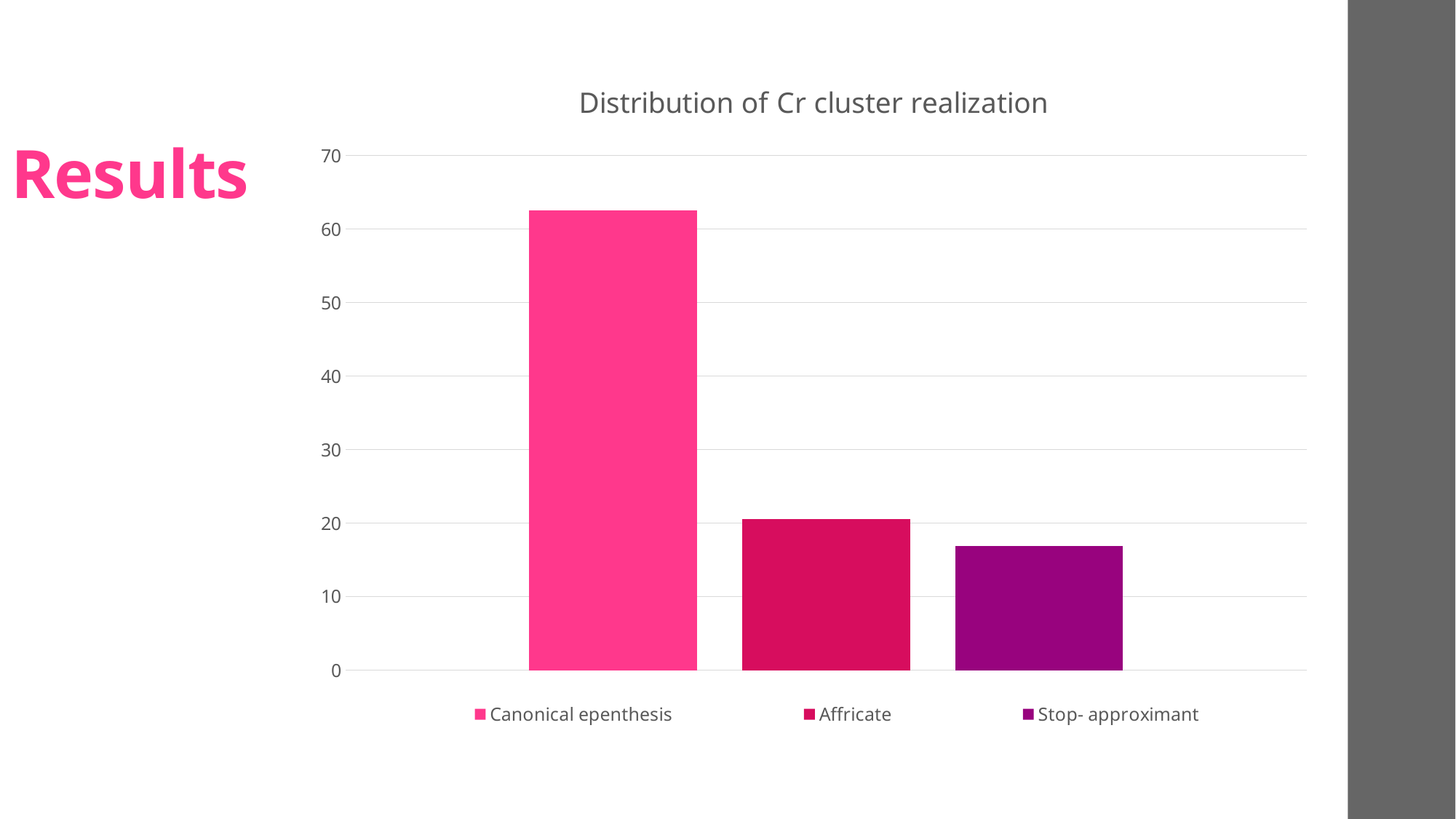
What is the title of the chart? Distribution of Cr cluster realization Is the value for Canonical epenthesis greater or less than 60? greater Which category has the highest value? Canonical epenthesis Which category has the lowest value? Stop- approximant Is the value for Stop- approximant greater or less than 20? less Is the value for Stop- approximant greater or less than 10? greater How many bars are plotted in the chart? 3 How many entries does the legend list? 3 Do the bar values rise or fall from left to right across the chart? Fall What type of chart is shown on the slide? Bar chart Which is larger, the value for Affricate or the value for Stop- approximant? Affricate